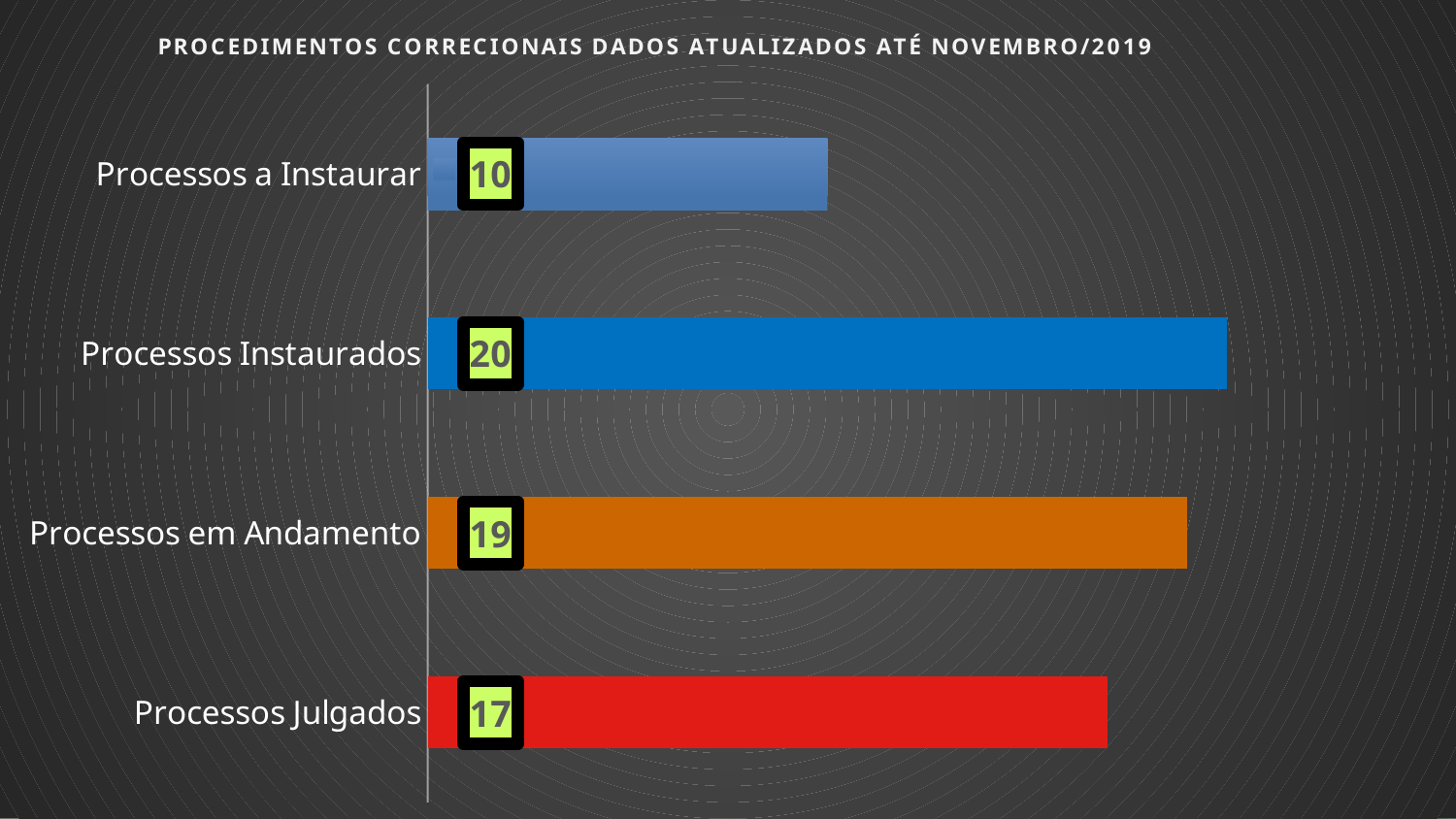
What is the value for Processos Julgados? 17 Which category has the lowest value? Processos a Instaurar How many categories are shown in the chart? 4 Which category has the highest value? Processos Instaurados What is the value for Processos Instaurados? 20 What is the difference between Processos em Andamento and Processos Julgados? 2 What kind of chart is this? Bar chart What is the value for Processos em Andamento? 19 Which is larger, Processos Julgados or Processos a Instaurar? Processos Julgados What is the difference between Processos Instaurados and Processos a Instaurar? 10 What is the title of the chart? PROCEDIMENTOS CORRECIONAIS DADOS ATUALIZADOS ATÉ NOVEMBRO/2019 What is the value for Processos a Instaurar? 10